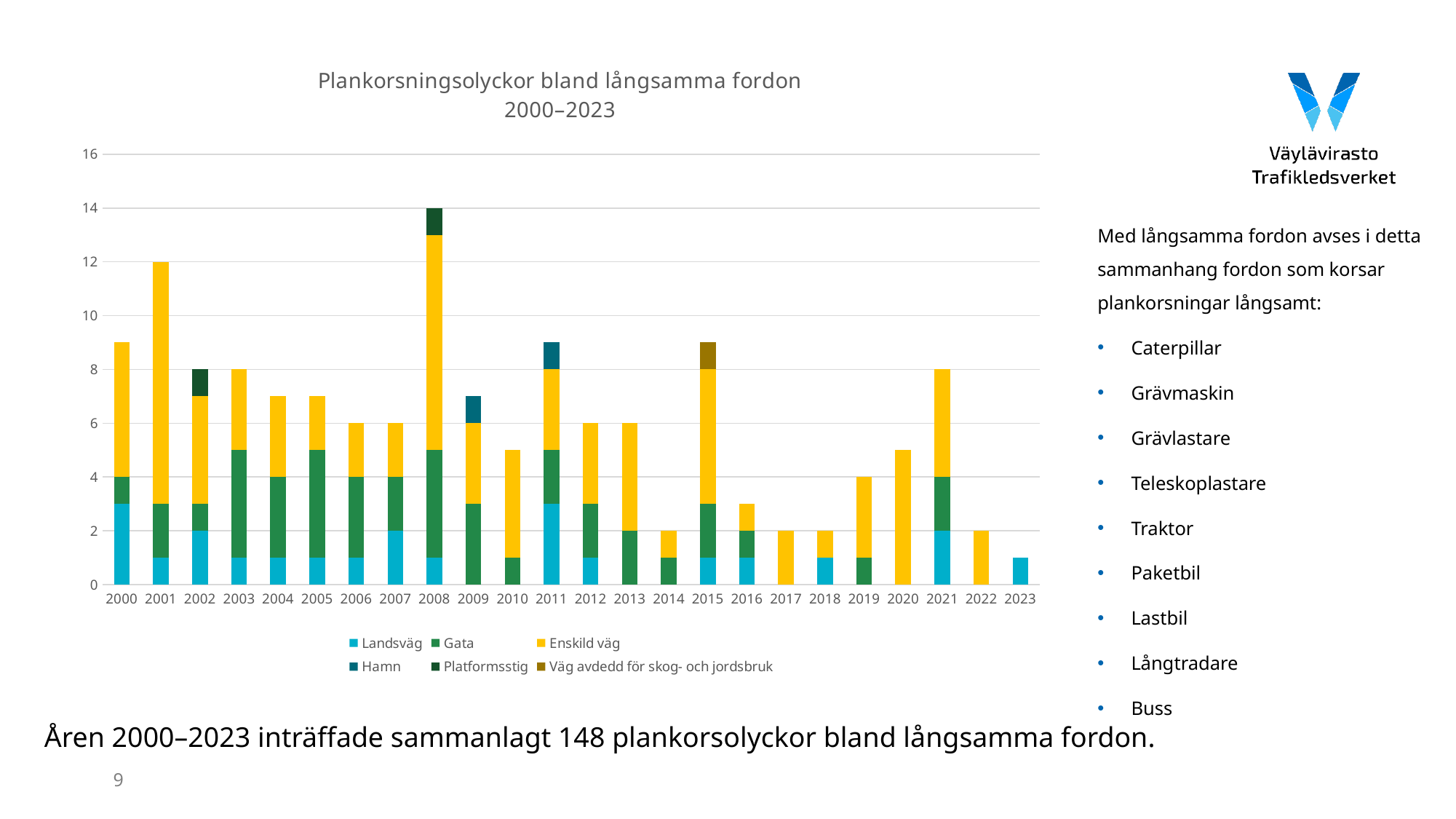
How many series does the chart legend list? 6 Is the total for 2000 greater or less than 8? greater What is the difference between the total for 2008 and the total for 2001? 2 What kind of chart is shown on the slide? Bar chart Which year has the highest total number of accidents in the chart? 2008 How many years are shown on the x axis of the chart? 24 What is the title of the chart? Plankorsningsolyckor bland långsamma fordon 2000–2023 What is the total height of the stacked bar for 2001? 12 Which year has the lowest total number of accidents in the chart? 2023 Which year has a larger total, 2019 or 2021? 2021 Is the total for 2010 greater or less than 6? less What is the total height of the stacked bar for 2008? 14